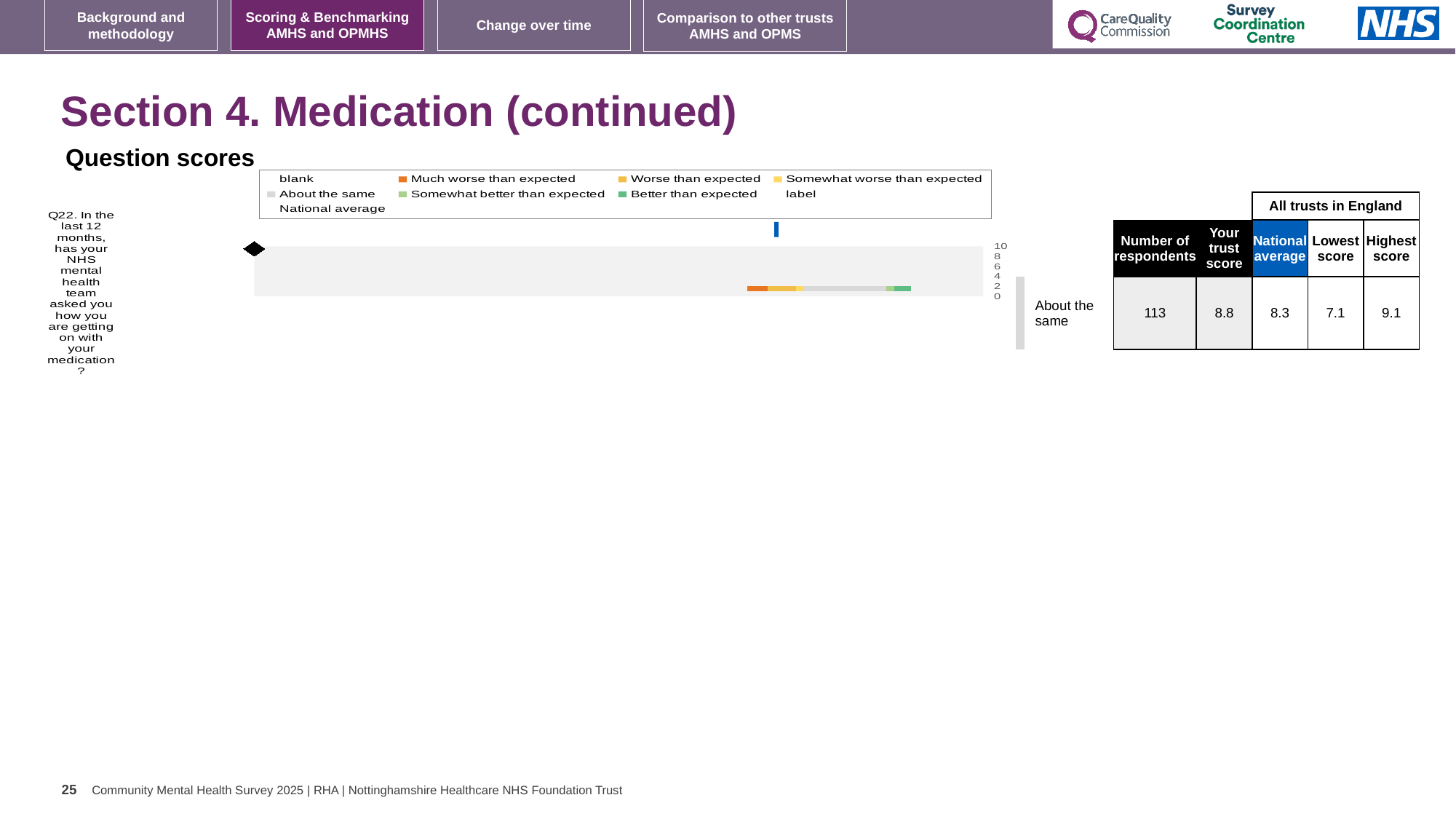
What is the national average score for Q22 shown next to the Question scores chart? 8.3 How many entries does the legend of the Question scores chart list? 9 How many questions are plotted in the Question scores chart? 1 For Q22, what is the difference between the highest score and the lowest score across all trusts in England? 2.0 What benchmark category is Q22 assigned in the Question scores chart? About the same How many respondents are recorded for Q22 next to the Question scores chart? 113 What kind of chart is shown under 'Question scores'? bar chart For Q22, which is larger: the trust score or the national average? the trust score What is the highest tick value shown on the score axis of the Question scores chart? 10 What is the trust score for Q22 shown next to the Question scores chart? 8.8 Is the trust score for Q22 greater or less than 8? greater Which legend entry in the Question scores chart is shown in orange? Much worse than expected